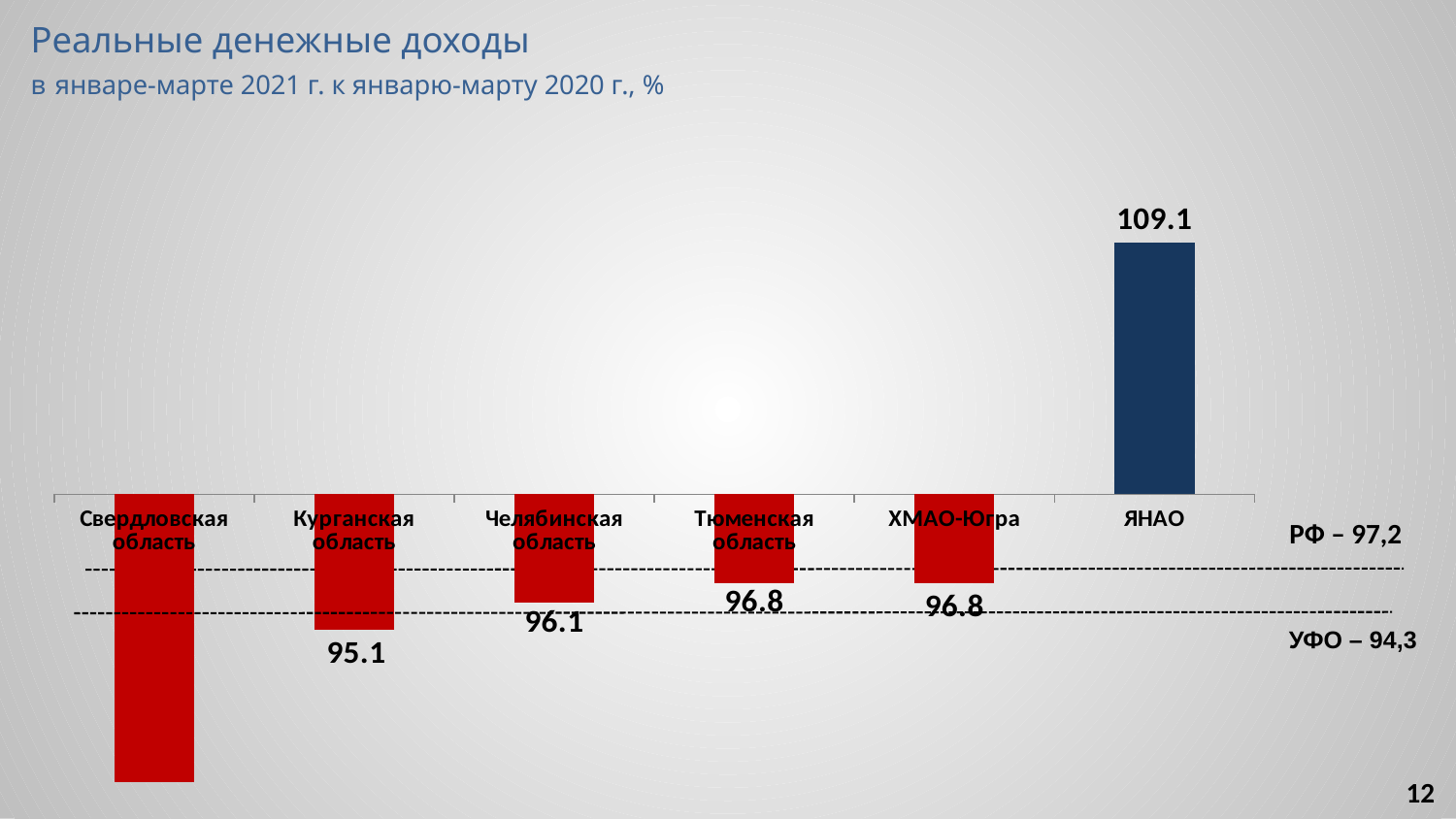
What is the difference between the values for Тюменская область and Челябинская область? 0.7 What is the difference between the values for ЯНАО and Курганская область? 14.0 Which region has the lowest value? Свердловская область What is the value for Тюменская область? 96.8 Which is larger, the value for Челябинская область or for Курганская область? Челябинская область What is the value for Курганская область? 95.1 What value is given for РФ on the slide? 97,2 What kind of chart is shown on the slide? bar chart Which region has the highest value? ЯНАО What is the value for ЯНАО? 109.1 How many regions are shown in the chart? 6 What is the value for Челябинская область? 96.1